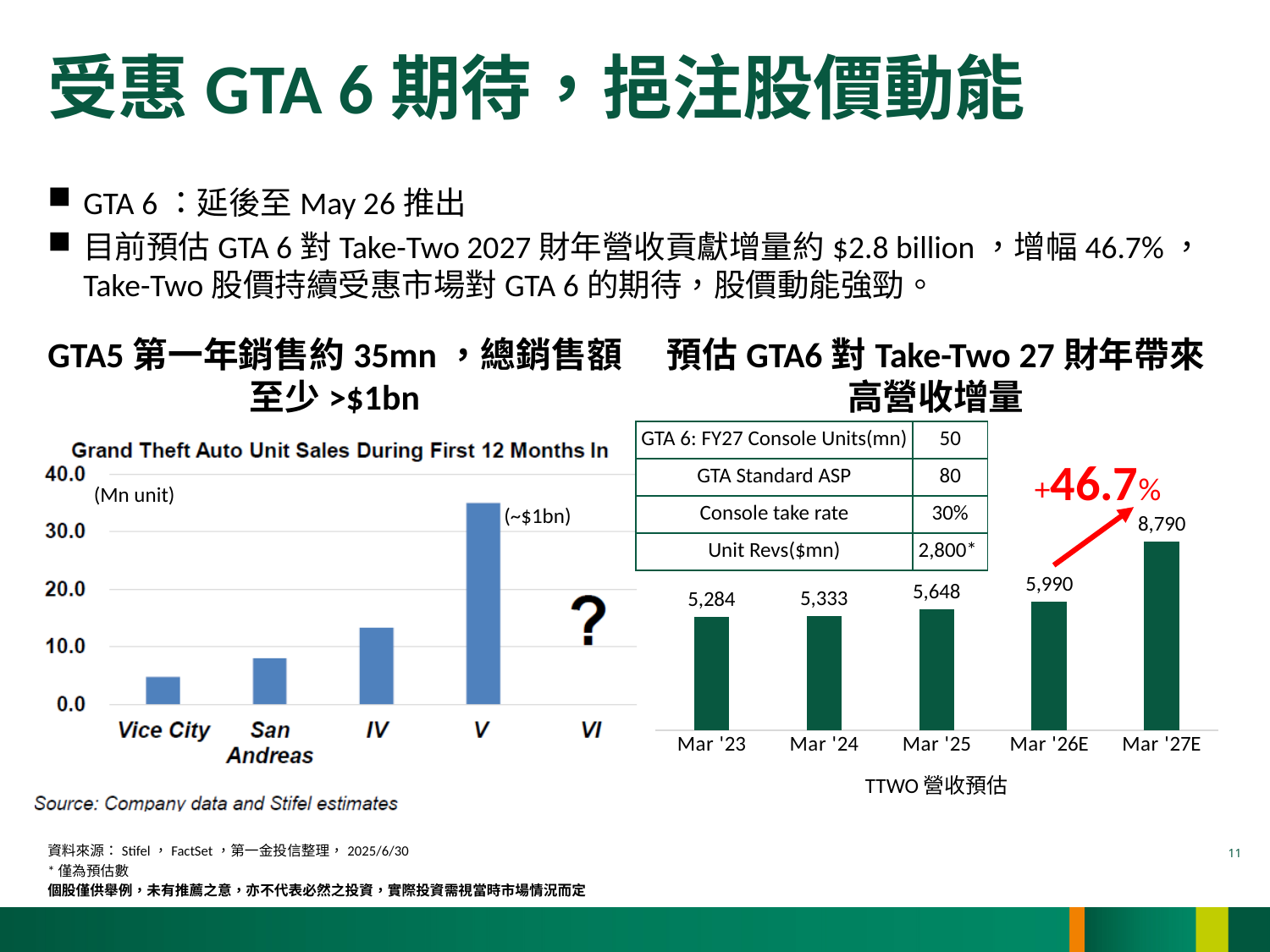
What kind of chart is the Grand Theft Auto Unit Sales chart on the left? bar chart In the TTWO 營收預估 chart on the right, what is the value for Mar '25? 5,648 In the TTWO 營收預估 chart on the right, which period has the highest value? Mar '27E In the TTWO 營收預估 chart on the right, what is the value for Mar '27E? 8,790 In the TTWO 營收預估 chart on the right, what is the value for Mar '23? 5,284 In the TTWO 營收預估 chart on the right, how many periods are shown on the x axis? 5 In the Grand Theft Auto Unit Sales chart on the left, is the value for Vice City greater or less than 10.0? less In the TTWO 營收預估 chart on the right, do the values rise or fall from Mar '23 to Mar '27E? rise In the Grand Theft Auto Unit Sales chart on the left, which of IV or San Andreas has the larger value? IV In the TTWO 營收預估 chart on the right, what is the difference between Mar '27E and Mar '26E? 2,800 In the Grand Theft Auto Unit Sales chart on the left, is the value for V greater or less than 30.0? greater In the TTWO 營收預估 chart on the right, which period has the lowest value? Mar '23